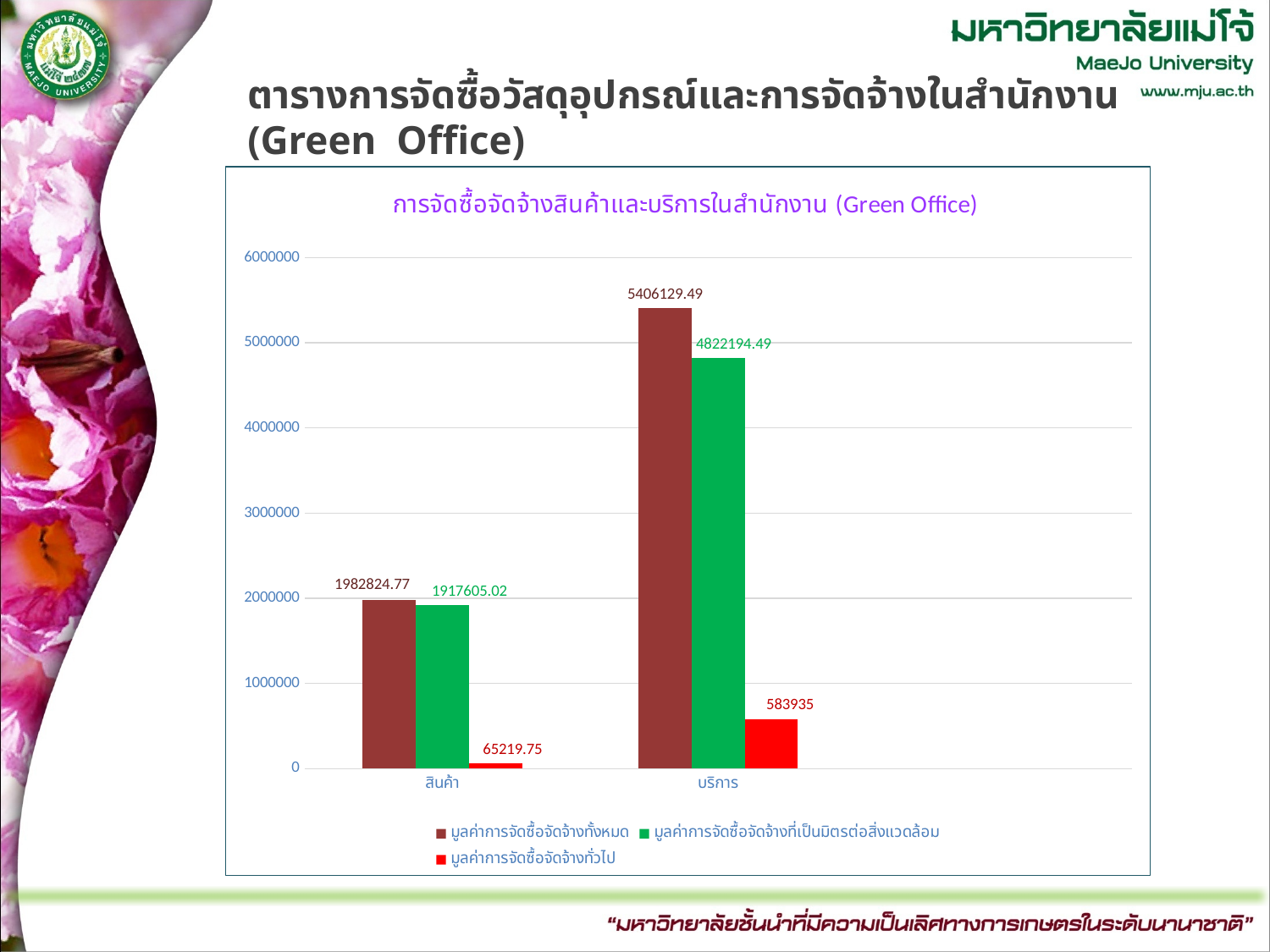
What is the difference between มูลค่าการจัดซื้อจัดจ้างทั้งหมด for บริการ and for สินค้า? 3423304.72 Which bar in the chart has the lowest value overall? มูลค่าการจัดซื้อจัดจ้างทั่วไป for สินค้า Which category has the highest value for มูลค่าการจัดซื้อจัดจ้างทั้งหมด? บริการ What is the value of มูลค่าการจัดซื้อจัดจ้างที่เป็นมิตรต่อสิ่งแวดล้อม for บริการ? 4822194.49 What type of chart is shown on the slide? Bar chart What is the value of มูลค่าการจัดซื้อจัดจ้างทั้งหมด for สินค้า? 1982824.77 What is the value of มูลค่าการจัดซื้อจัดจ้างทั่วไป for บริการ? 583935 How many categories are shown on the x axis? 2 Which is larger: มูลค่าการจัดซื้อจัดจ้างทั่วไป for สินค้า or for บริการ? บริการ How many series does the legend list? 3 What is the value of มูลค่าการจัดซื้อจัดจ้างทั่วไป for สินค้า? 65219.75 What is the difference between มูลค่าการจัดซื้อจัดจ้างทั้งหมด and มูลค่าการจัดซื้อจัดจ้างที่เป็นมิตรต่อสิ่งแวดล้อม for บริการ? 583935